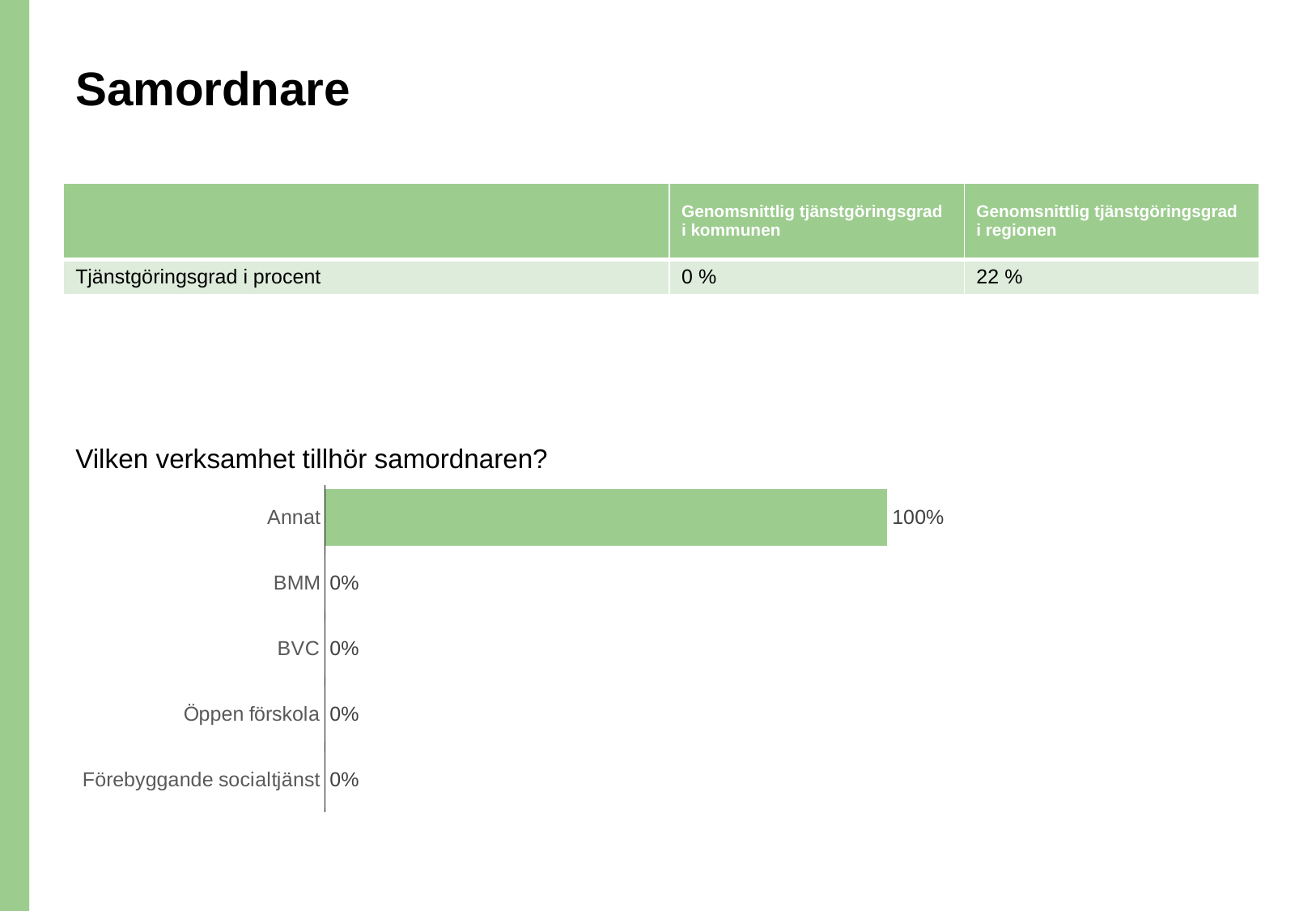
How many categories in the chart 'Vilken verksamhet tillhör samordnaren?' have a value of 0%? 4 What is the value for Förebyggande socialtjänst in the chart 'Vilken verksamhet tillhör samordnaren?'? 0% How many categories are shown in the chart 'Vilken verksamhet tillhör samordnaren?'? 5 What is the title of the chart on the slide? Vilken verksamhet tillhör samordnaren? What colour are the bars in the chart 'Vilken verksamhet tillhör samordnaren?'? Green Which is larger in the chart 'Vilken verksamhet tillhör samordnaren?': the value for Annat or the value for BVC? Annat What is the difference between the values for Annat and BMM in the chart 'Vilken verksamhet tillhör samordnaren?'? 100% Which category has the highest value in the chart 'Vilken verksamhet tillhör samordnaren?'? Annat What is the value for Annat in the chart 'Vilken verksamhet tillhör samordnaren?'? 100% What kind of chart is 'Vilken verksamhet tillhör samordnaren?'? Bar chart What is the value for Öppen förskola in the chart 'Vilken verksamhet tillhör samordnaren?'? 0% What is the value for BVC in the chart 'Vilken verksamhet tillhör samordnaren?'? 0%